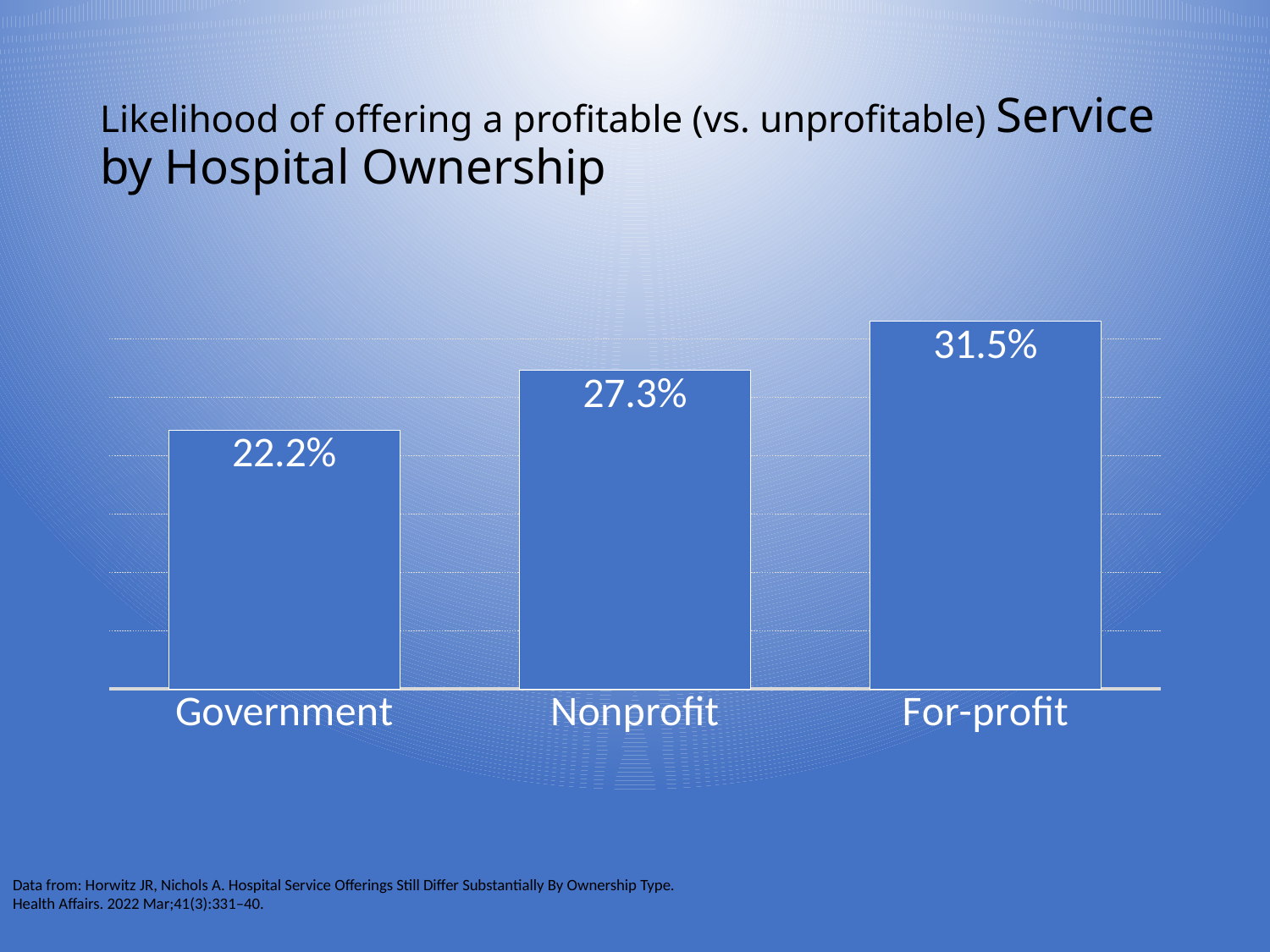
Which hospital ownership type has the lowest value? Government What is the difference between the values for For-profit and Nonprofit? 4.2% What is the value for Nonprofit? 27.3% What is the value for Government? 22.2% Which is larger, the value for Nonprofit or the value for Government? Nonprofit What is the difference between the values for For-profit and Government? 9.3% What kind of chart is shown on the slide? Bar chart What is the value for For-profit? 31.5% How many hospital ownership categories are shown in the chart? 3 Which hospital ownership type has the highest value? For-profit Do the values rise or fall from Government to For-profit along the x axis? Rise What is the difference between the values for Nonprofit and Government? 5.1%